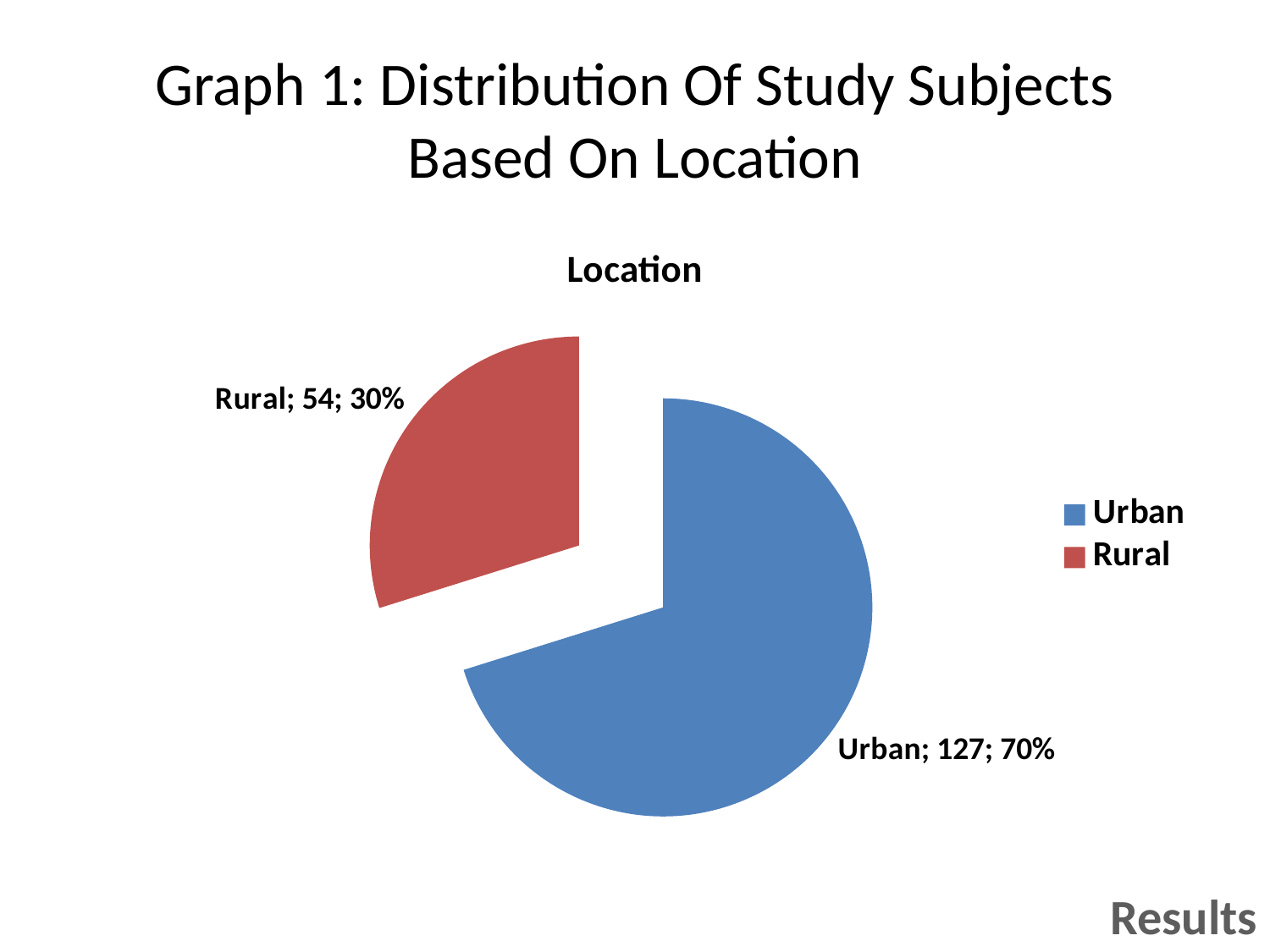
How many study subjects are from Urban locations? 127 What percentage of study subjects are from Rural locations? 30% Which has more study subjects, Urban or Rural? Urban How many slices does the pie chart have? 2 How many study subjects are from Rural locations? 54 What type of chart is shown on the slide? pie chart What is the difference between the number of Urban and Rural study subjects? 73 Which location category has the largest number of study subjects? Urban Which location category has the smallest number of study subjects? Rural What is the total number of study subjects shown in the pie chart? 181 What is the title shown directly above the pie chart? Location What share of the pie does the Urban slice represent? 70%